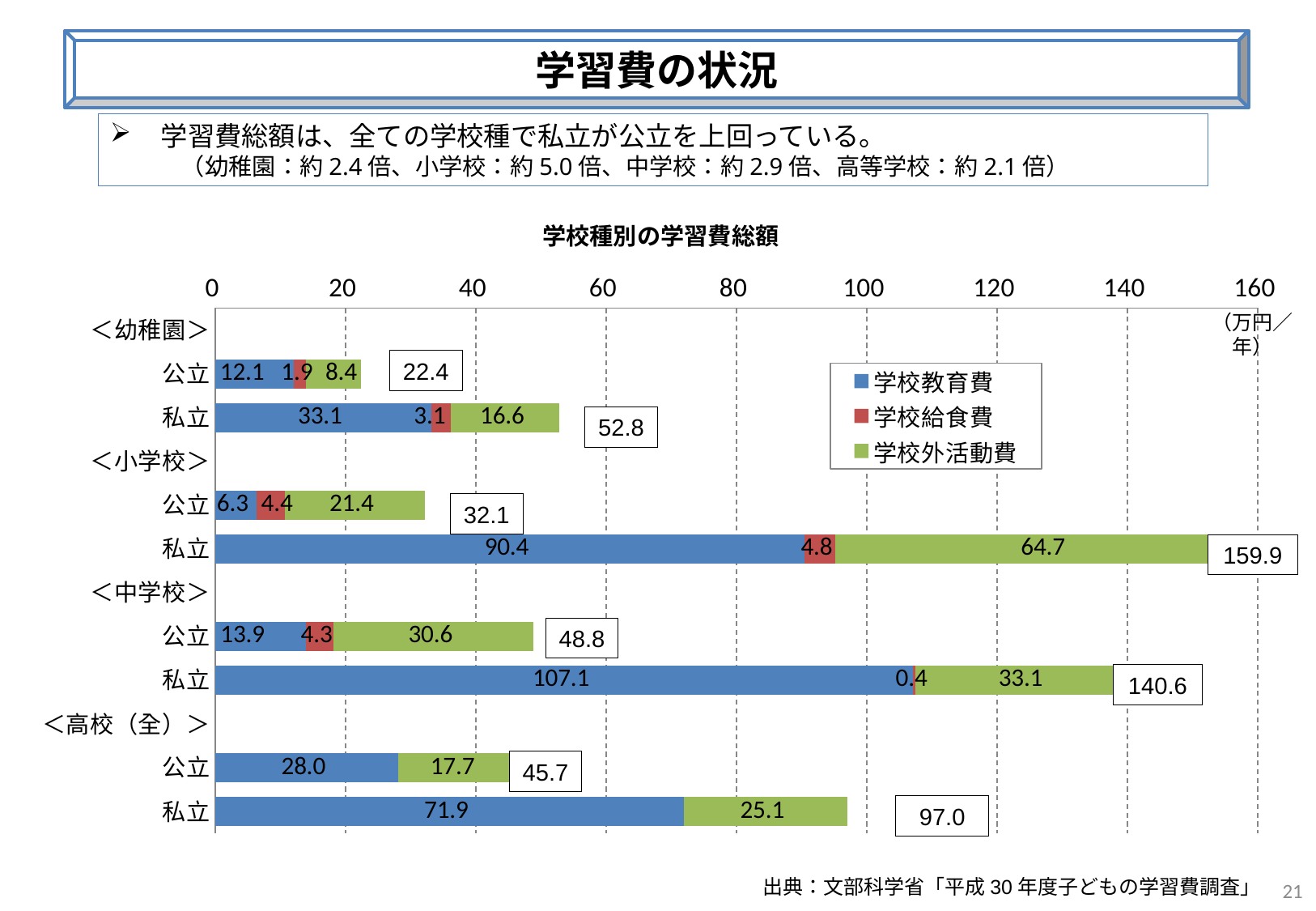
Which bar has the lowest total 学習費? 幼稚園 公立 What is the 学校教育費 value for 小学校 私立? 90.4 What is the 学校外活動費 value for 中学校 公立? 30.6 How many 公立/私立 bars are plotted in the chart? 8 What kind of chart is shown on the slide? Stacked bar chart What is the difference between the total for 中学校 私立 and 中学校 公立? 91.8 How many series does the legend list? 3 What is the total 学習費 for 高校（全） 私立? 97.0 Which bar has the highest total 学習費? 小学校 私立 What is the 学校給食費 value for 幼稚園 私立? 3.1 Which is larger, the 学校外活動費 for 小学校 私立 or for 中学校 私立? 小学校 私立 What is the title of the chart? 学校種別の学習費総額